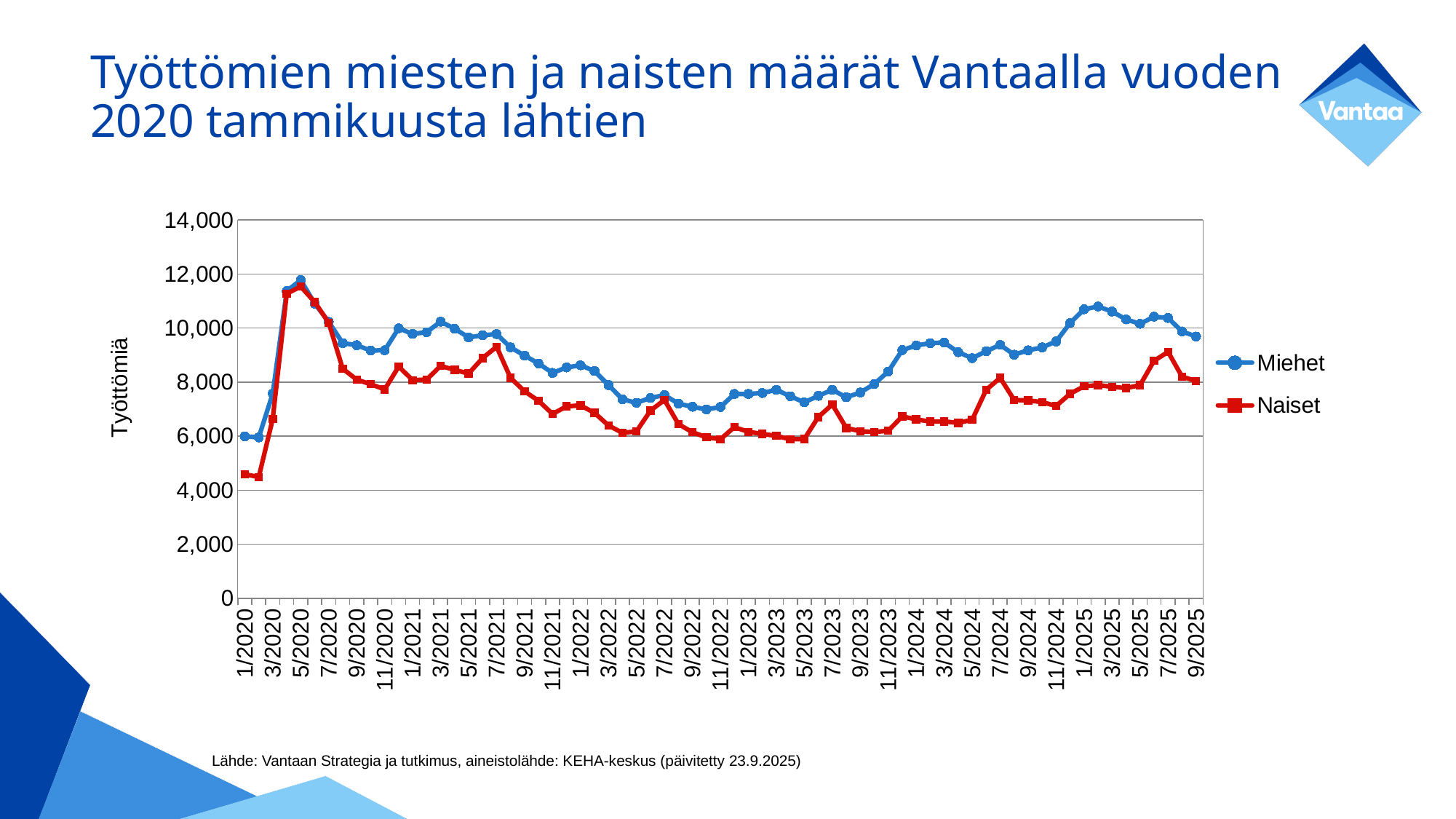
What kind of chart is shown on the slide? Line chart Is the value for Miehet in 5/2020 greater or less than 10,000? greater What are the two series named in the legend? Miehet and Naiset In which month does the Miehet series reach its highest value? 5/2020 Is the value for Miehet in 9/2025 greater or less than 10,000? less Which series is drawn in blue? Miehet Is the value for Naiset in 7/2025 greater or less than 8,000? greater How many series does the legend list? 2 Which series has the higher value in 9/2025, Miehet or Naiset? Miehet Do the values for Miehet rise or fall between 1/2020 and 5/2020? rise What is the label on the vertical axis? Työttömiä